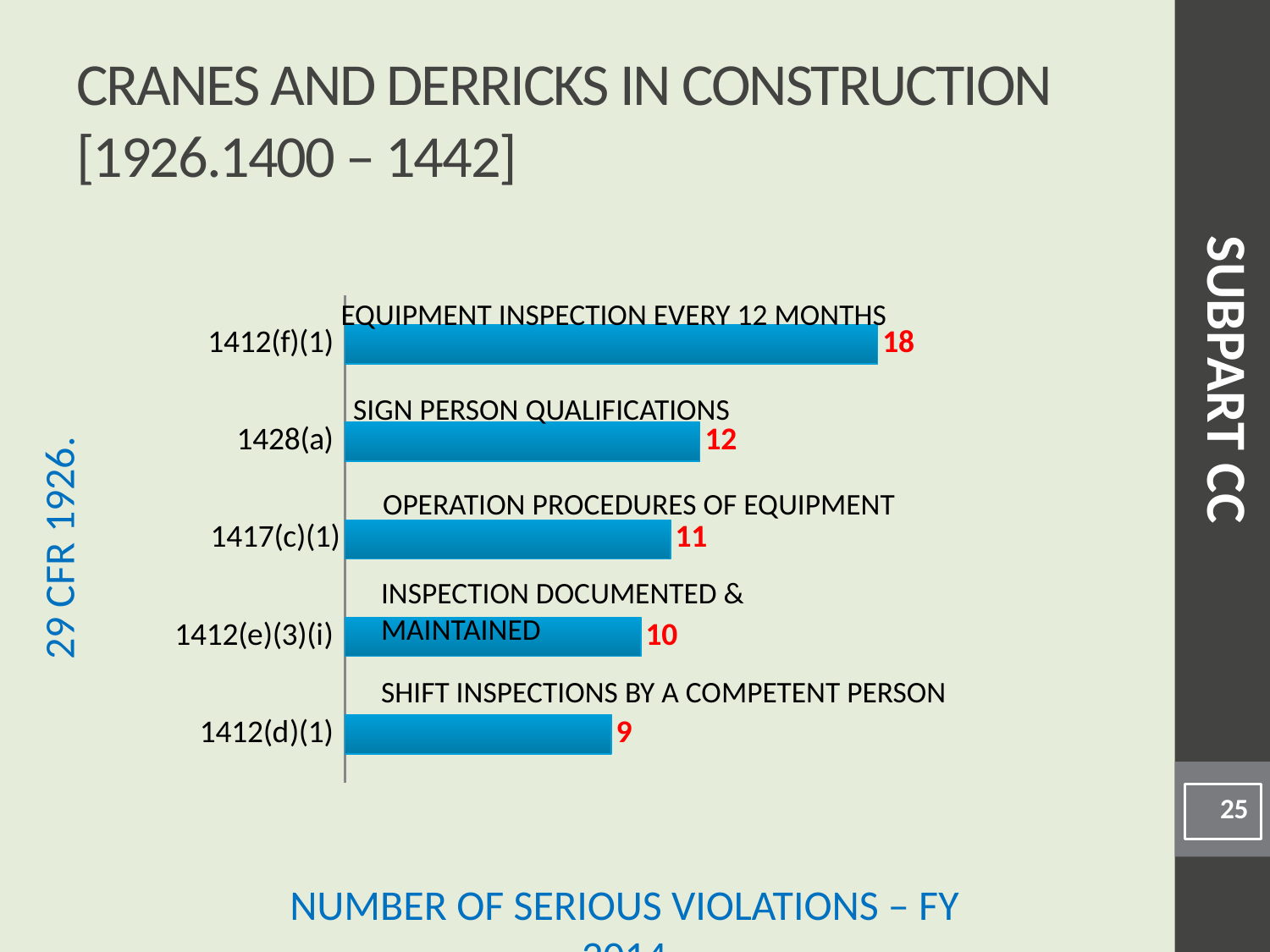
Which standard is described as 'SIGN PERSON QUALIFICATIONS'? 1428(a) What is the number of serious violations for 1412(f)(1)? 18 What is the number of serious violations for 1412(e)(3)(i)? 10 What is the difference in serious violations between 1412(f)(1) and 1428(a)? 6 What kind of chart is shown on the slide? Bar chart Which standard has the lowest number of serious violations? 1412(d)(1) Which has more serious violations, 1417(c)(1) or 1412(e)(3)(i)? 1417(c)(1) What is the number of serious violations for 1417(c)(1)? 11 How many standards are shown in the chart? 5 What is the number of serious violations for 1412(d)(1)? 9 Which standard has the highest number of serious violations? 1412(f)(1) What is the number of serious violations for 1428(a)? 12